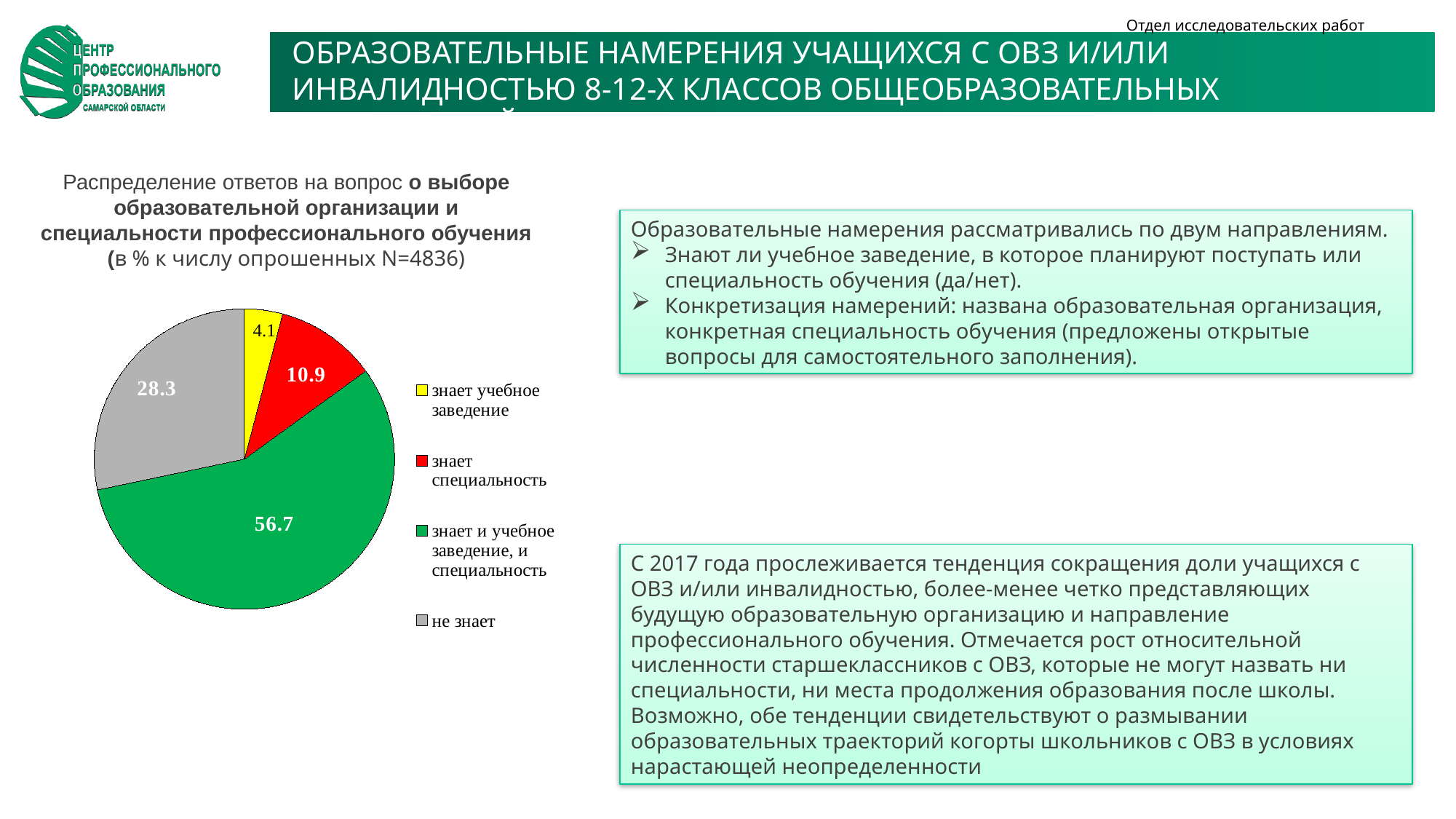
What type of chart is shown on the slide? pie chart What is the value for "знает и учебное заведение, и специальность"? 56.7 What is the number of respondents (N) stated in the chart title? 4836 What is the value for "знает учебное заведение"? 4.1 Which category has the largest slice of the pie? знает и учебное заведение, и специальность Which category has the smallest slice of the pie? знает учебное заведение How many categories does the pie chart have? 4 What colour is the slice for "не знает"? grey What is the value for "не знает"? 28.3 What is the difference between the values for "знает и учебное заведение, и специальность" and "не знает"? 28.4 Which is larger: the value for "знает специальность" or the value for "знает учебное заведение"? знает специальность What is the value for "знает специальность"? 10.9